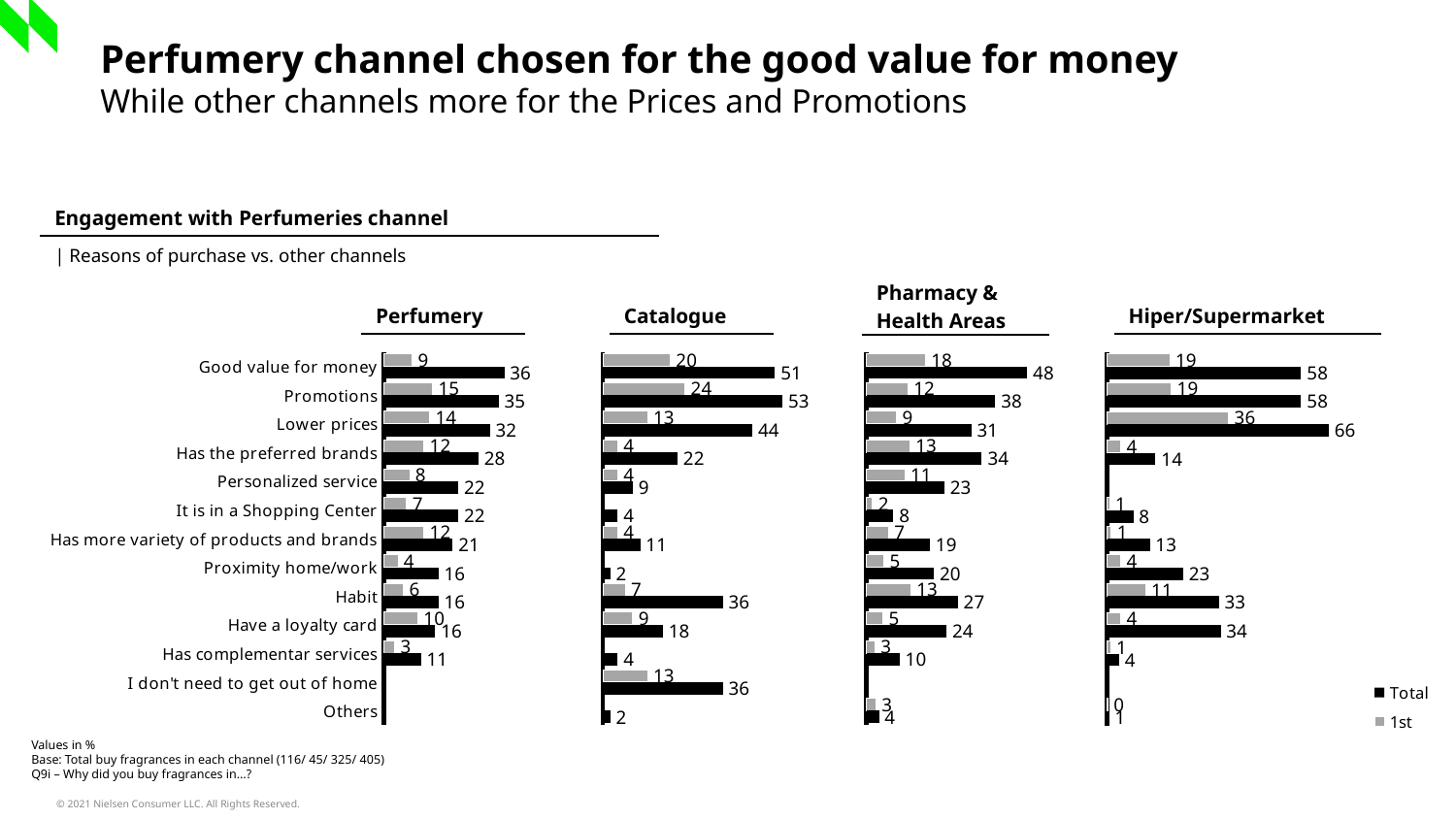
In the Pharmacy & Health Areas chart, what is the 1st value for Has the preferred brands? 13 In the Perfumery chart, what is the Total value for Good value for money? 36 What type of chart is used for the Perfumery data? Bar chart In the Catalogue chart, what is the Total value for Promotions? 53 How many series does the legend list? 2 In the Catalogue chart, which is larger: the Total value for Habit or the Total value for Have a loyalty card? Habit In the Hiper/Supermarket chart, which reason has the highest Total value? Lower prices How many charts are shown on the slide? 4 In the Perfumery chart, what is the difference between the Total values for Good value for money and Has complementar services? 25 In the Hiper/Supermarket chart, what is the 1st value for Lower prices? 36 In the Catalogue chart, what is the Total value for I don't need to get out of home? 36 In the Pharmacy & Health Areas chart, which reason has the highest Total value? Good value for money